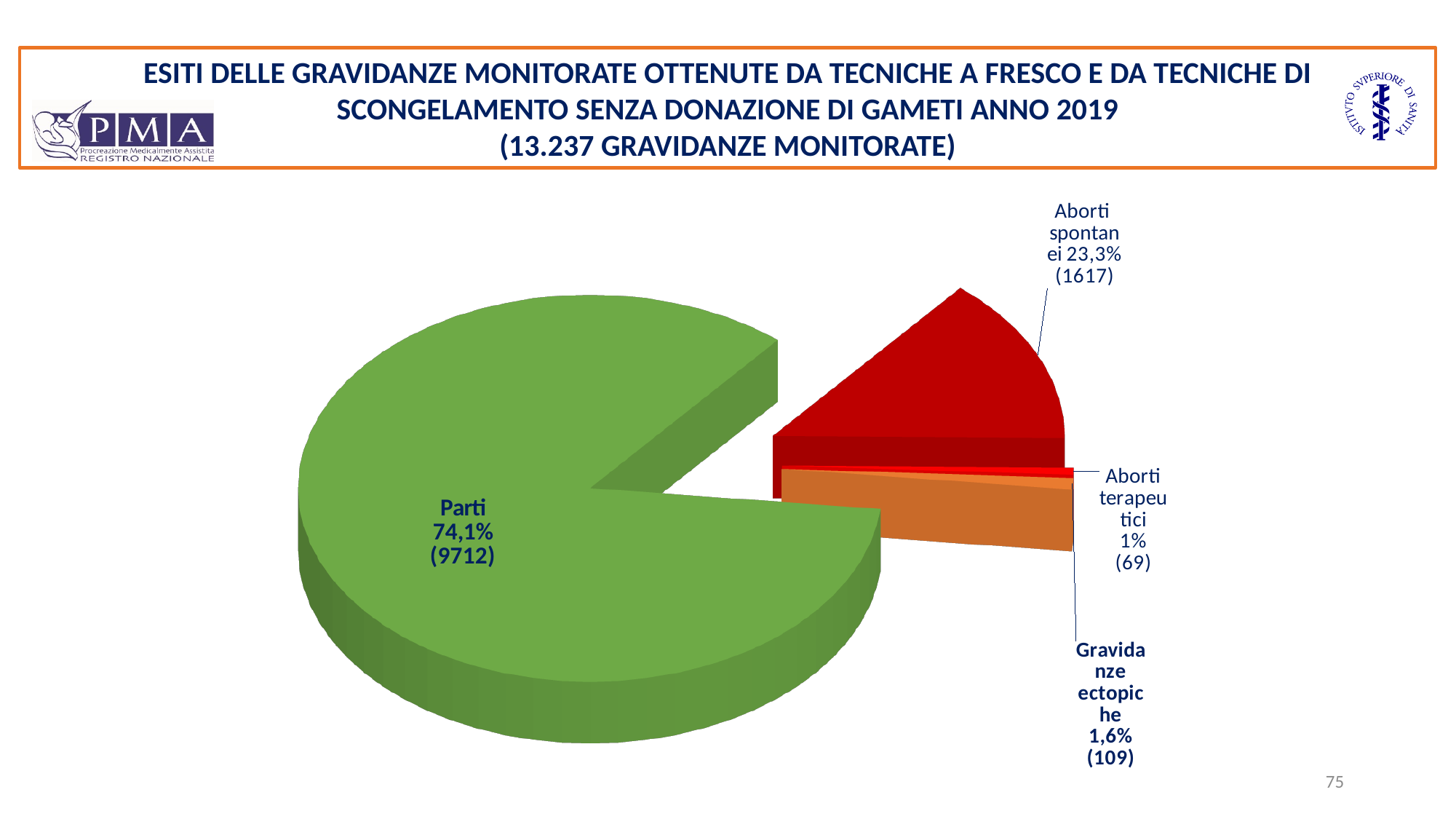
Which category has the smallest slice of the pie? Aborti terapeutici What is the count shown for Parti? 9712 What percentage share does the Parti slice represent? 74,1% What is the difference in count between Parti and Aborti spontanei? 8095 How many slices does the pie chart have? 4 What percentage share does the Aborti spontanei slice represent? 23,3% Which is larger, the count for Gravidanze ectopiche or the count for Aborti terapeutici? Gravidanze ectopiche Which category has the largest slice of the pie? Parti What is the count shown for Aborti spontanei? 1617 What percentage share does the Gravidanze ectopiche slice represent? 1,6% What is the count shown for Aborti terapeutici? 69 What kind of chart is shown on the slide? pie chart